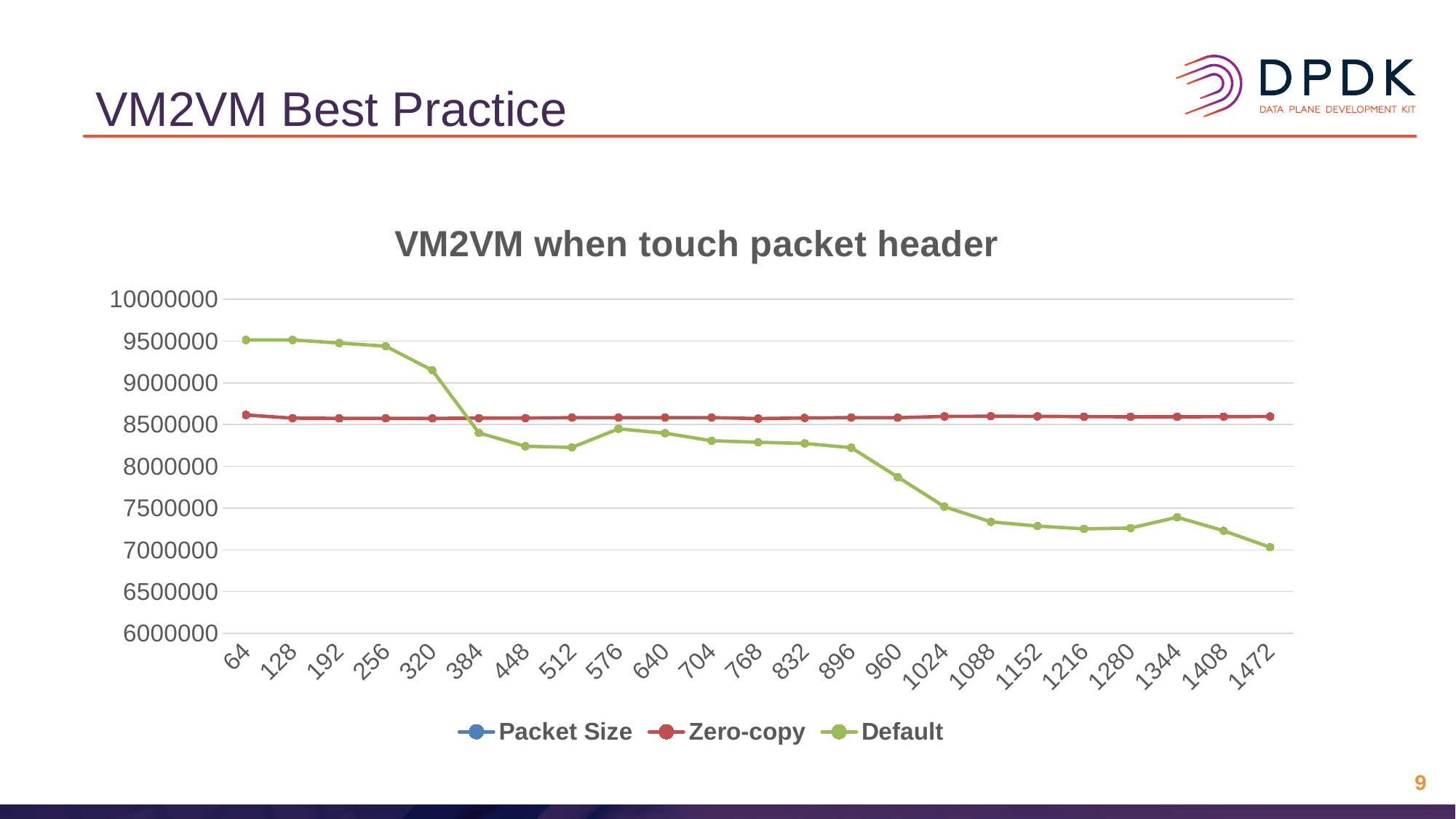
Does the Default series generally rise or fall as packet size increases along the x axis? Fall Is the value for Zero-copy at packet size 64 greater or less than 8500000? greater Is the value for Default at packet size 1472 greater or less than 7500000? less At packet size 1472, which series has the larger value, Zero-copy or Default? Zero-copy Is the value for Default at packet size 64 greater or less than 9000000? greater How many packet size categories are shown on the x axis? 23 How many series does the legend list? 3 Which series are listed in the legend? Packet Size, Zero-copy, Default What kind of chart is shown on the slide? Line chart What is the title of the chart? VM2VM when touch packet header At packet size 64, which series has the larger value, Zero-copy or Default? Default